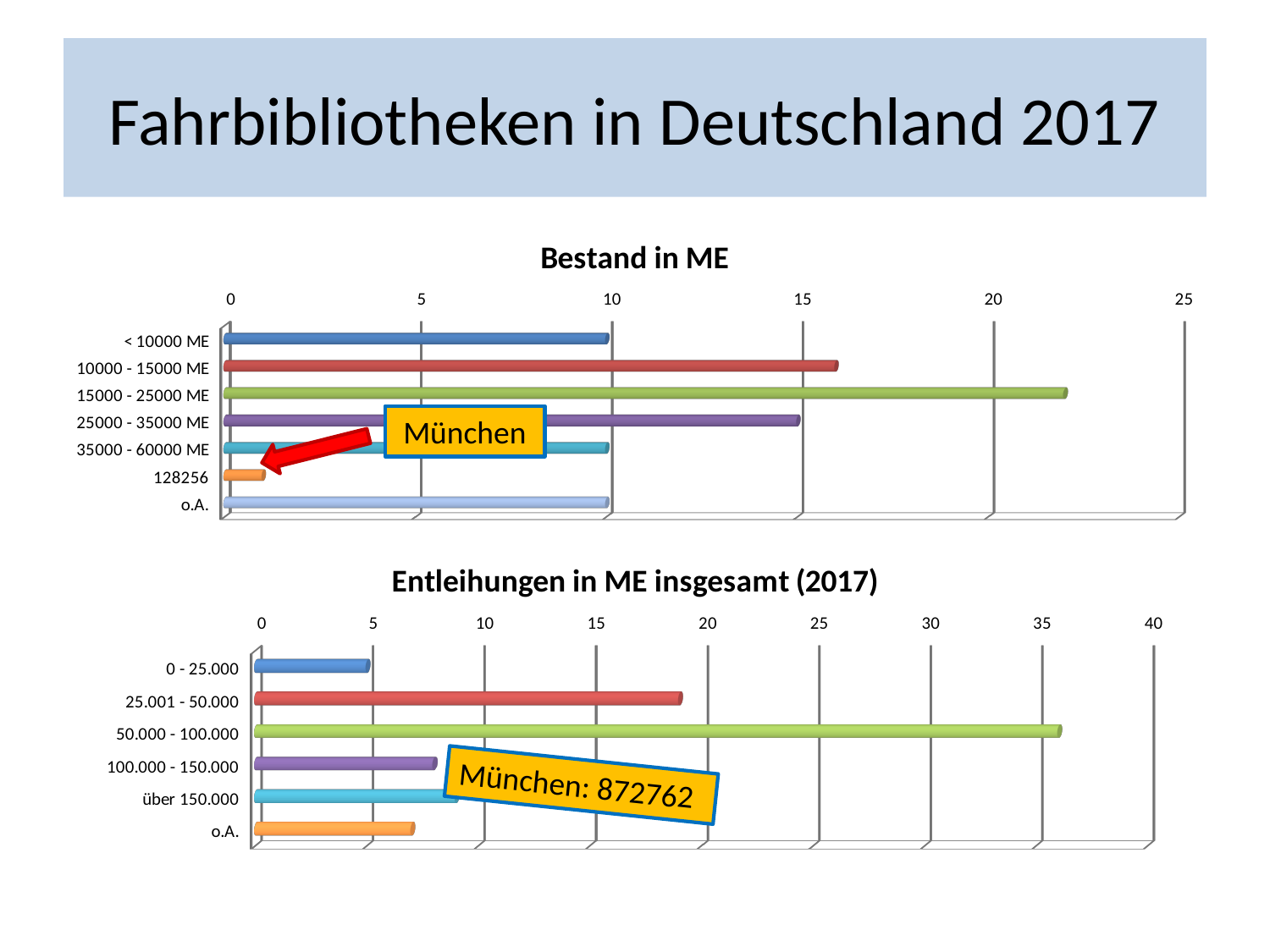
In the "Entleihungen in ME insgesamt (2017)" chart, is the value for 50.000 - 100.000 greater or less than 30? greater What type of chart is the "Bestand in ME" chart? bar chart In the "Bestand in ME" chart, is the value for 15000 - 25000 ME greater or less than 20? greater In the "Bestand in ME" chart, which is larger: the value for 10000 - 15000 ME or the value for 25000 - 35000 ME? 10000 - 15000 ME How many categories are shown in the "Entleihungen in ME insgesamt (2017)" chart? 6 In the "Entleihungen in ME insgesamt (2017)" chart, which category has the highest value? 50.000 - 100.000 In the "Entleihungen in ME insgesamt (2017)" chart, is the value for 25.001 - 50.000 greater or less than 15? greater How many categories are shown in the "Bestand in ME" chart? 7 In the "Entleihungen in ME insgesamt (2017)" chart, which is larger: the value for 25.001 - 50.000 or the value for 100.000 - 150.000? 25.001 - 50.000 In the "Bestand in ME" chart, which category has the lowest value? 128256 In the "Bestand in ME" chart, which category has the highest value? 15000 - 25000 ME